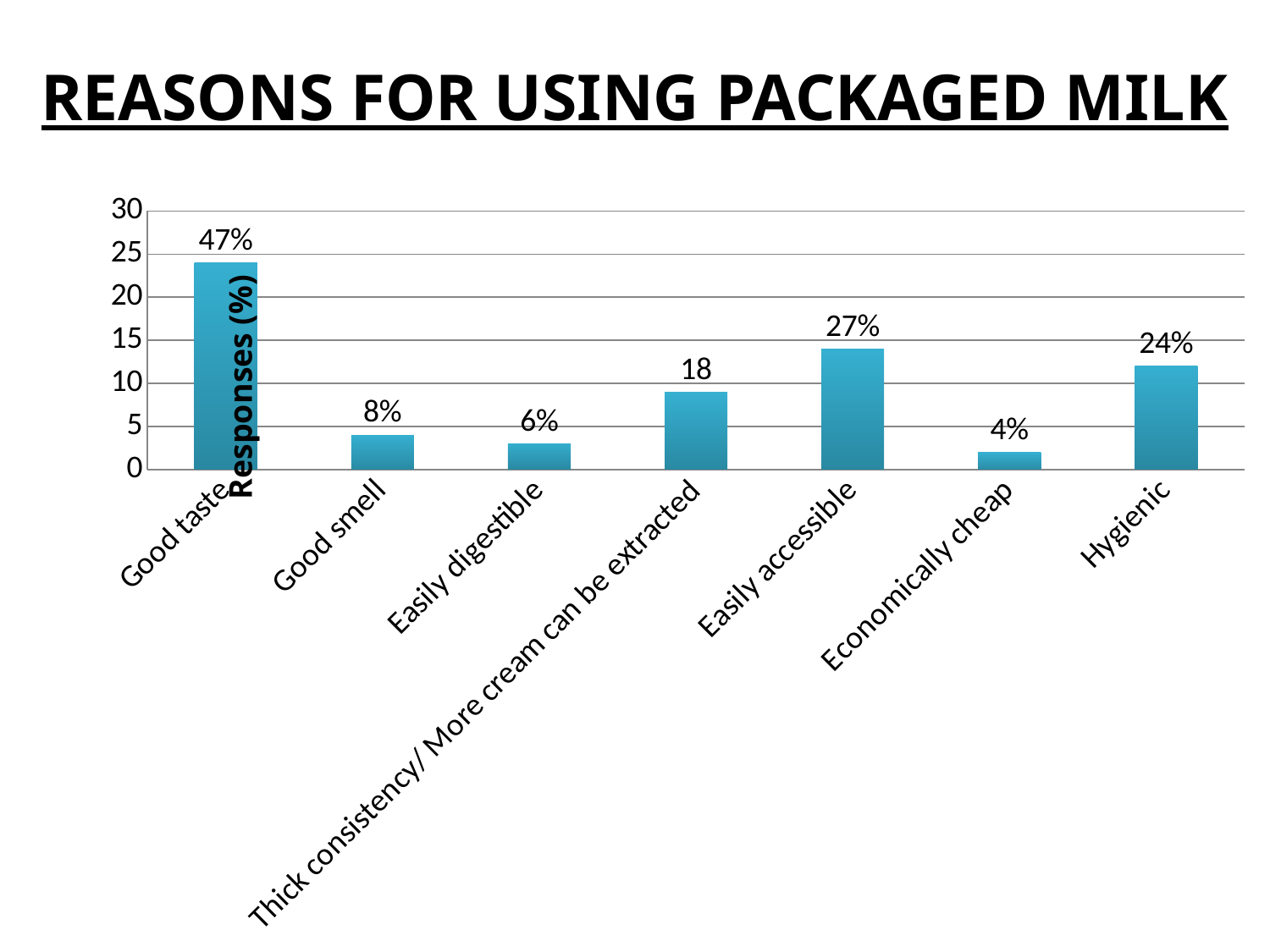
What is the data label shown for Good taste? 47% What kind of chart is shown on the slide? Bar chart What is the data label shown for Hygienic? 24% Which has a larger value, Good smell or Easily digestible? Good smell What is the data label shown for Economically cheap? 4% How many reasons (categories) are shown on the chart? 7 What is the data label shown for Easily accessible? 27% Which reason has the lowest bar? Economically cheap What is the label on the vertical axis of the chart? Responses (%) Is the bar for Good taste greater or less than 20 on the axis? greater What is the data label shown for Thick consistency/ More cream can be extracted? 18 Which reason has the highest bar? Good taste